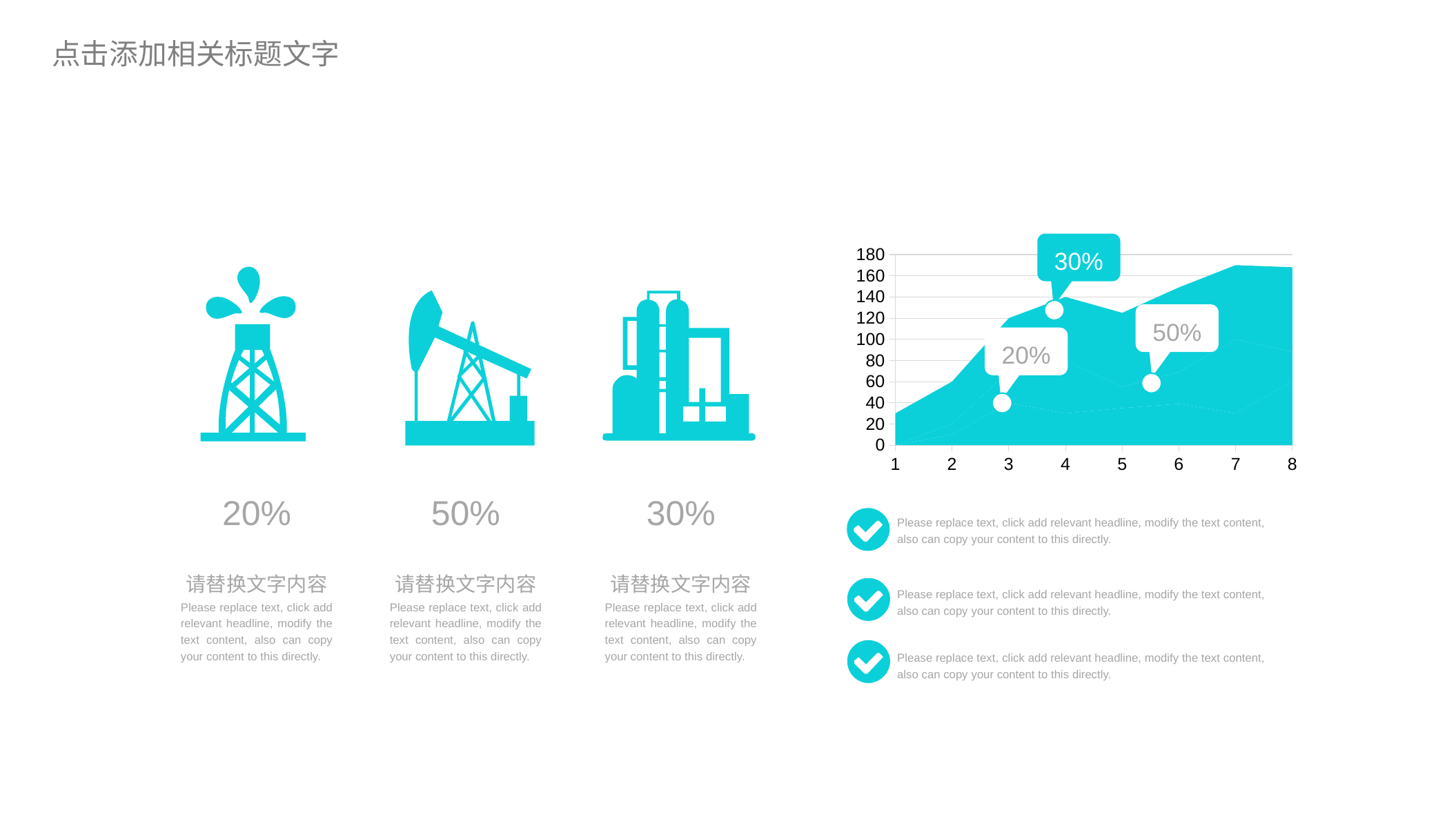
What kind of chart is shown on the right side of the slide? area chart Is the value at x = 1 in the area chart greater or less than 60? less What is the highest tick value shown on the y axis of the area chart? 180 Is the value at x = 5 in the area chart greater or less than 100? greater Is the value at x = 3 in the area chart greater or less than 100? greater Do the values in the area chart generally rise or fall from x = 1 to x = 8? rise In the area chart, which has the larger value: x = 2 or x = 4? 4 In the area chart, which has the larger value: x = 1 or x = 7? 7 Which x-axis category has the lowest value in the area chart? 1 How many points are plotted along the x axis of the area chart? 8